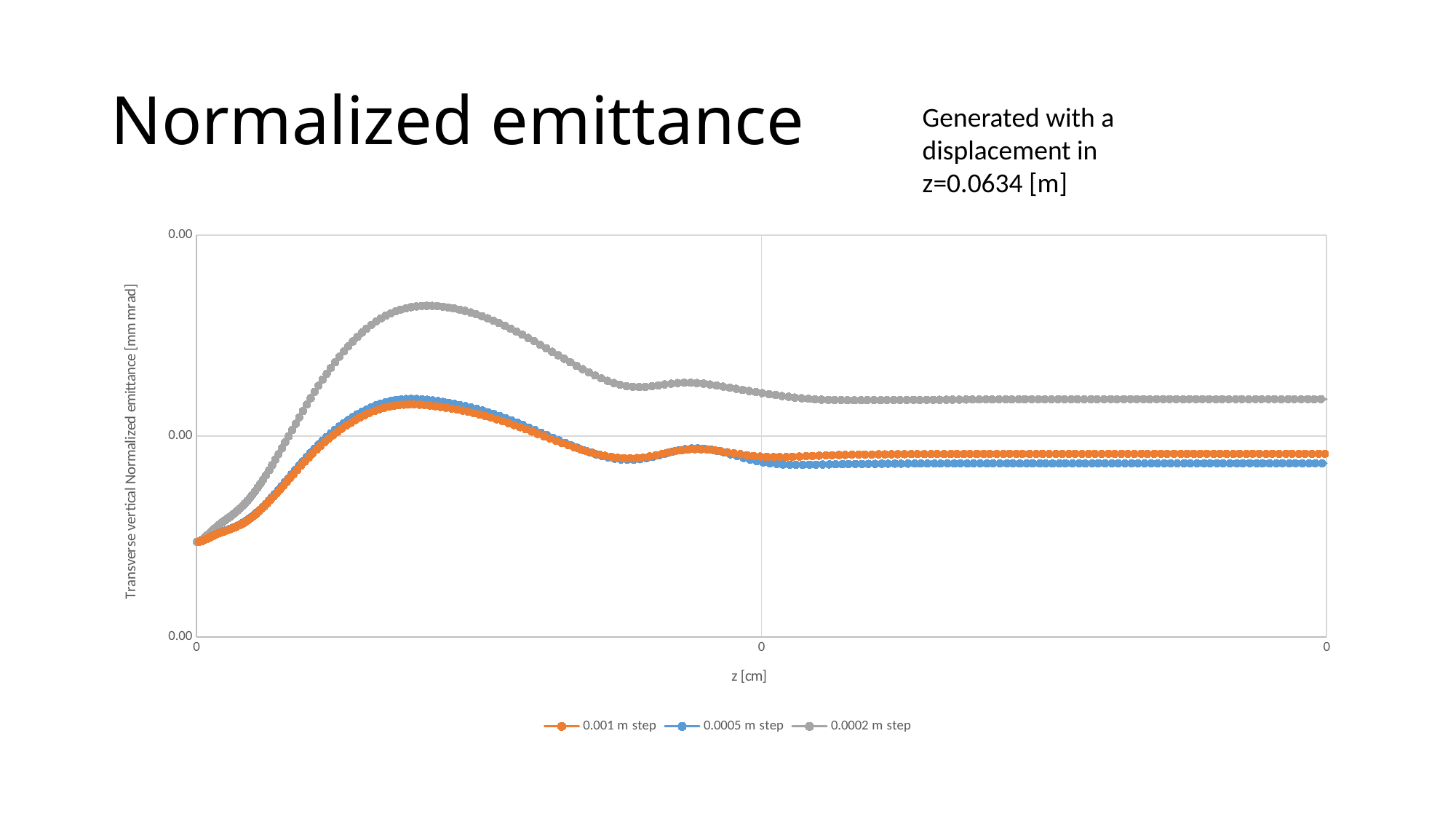
What are the three series named in the legend? 0.001 m step, 0.0005 m step, 0.0002 m step How many series does the legend list? 3 What is the title of the x axis? z [cm] Do the values of the 0.0002 m step series rise or fall at the start of the x axis? rise After reaching its peak, do the values of the 0.001 m step series rise or fall? fall Which series reaches the highest peak value? 0.0002 m step What kind of chart is shown on the slide? line chart Which series has the lower peak, 0.001 m step or 0.0002 m step? 0.001 m step At the right end of the x axis, which series has the larger value, 0.0002 m step or 0.001 m step? 0.0002 m step At the right end of the x axis, which series has the lowest value? 0.0005 m step